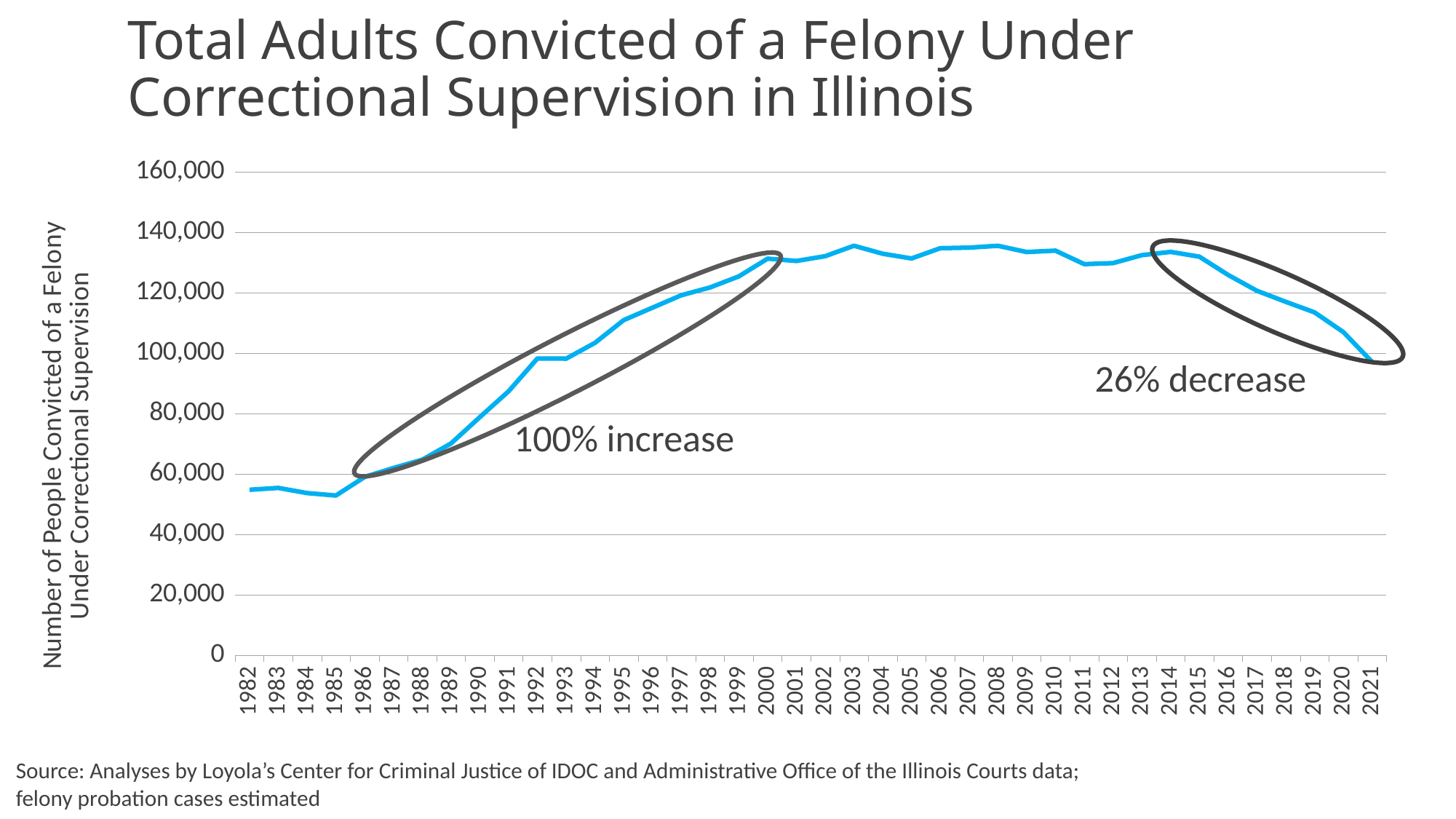
What percentage decrease is annotated on the chart for the decline after 2014? 26% decrease Which year has the larger value, 1990 or 2000? 2000 What is the title of the chart? Total Adults Convicted of a Felony Under Correctional Supervision in Illinois Is the value for 2021 greater or less than 120,000? less Does the number of people under correctional supervision rise or fall between 2014 and 2021? fall What kind of chart is shown on the slide? line chart How many years are shown along the x axis of the chart? 40 What percentage increase is annotated on the chart for the rise from the mid-1980s to 2000? 100% increase Is the value for 2003 greater or less than 120,000? greater Is the value for 1992 greater or less than 80,000? greater Does the number of people under correctional supervision rise or fall between 1986 and 2000? rise